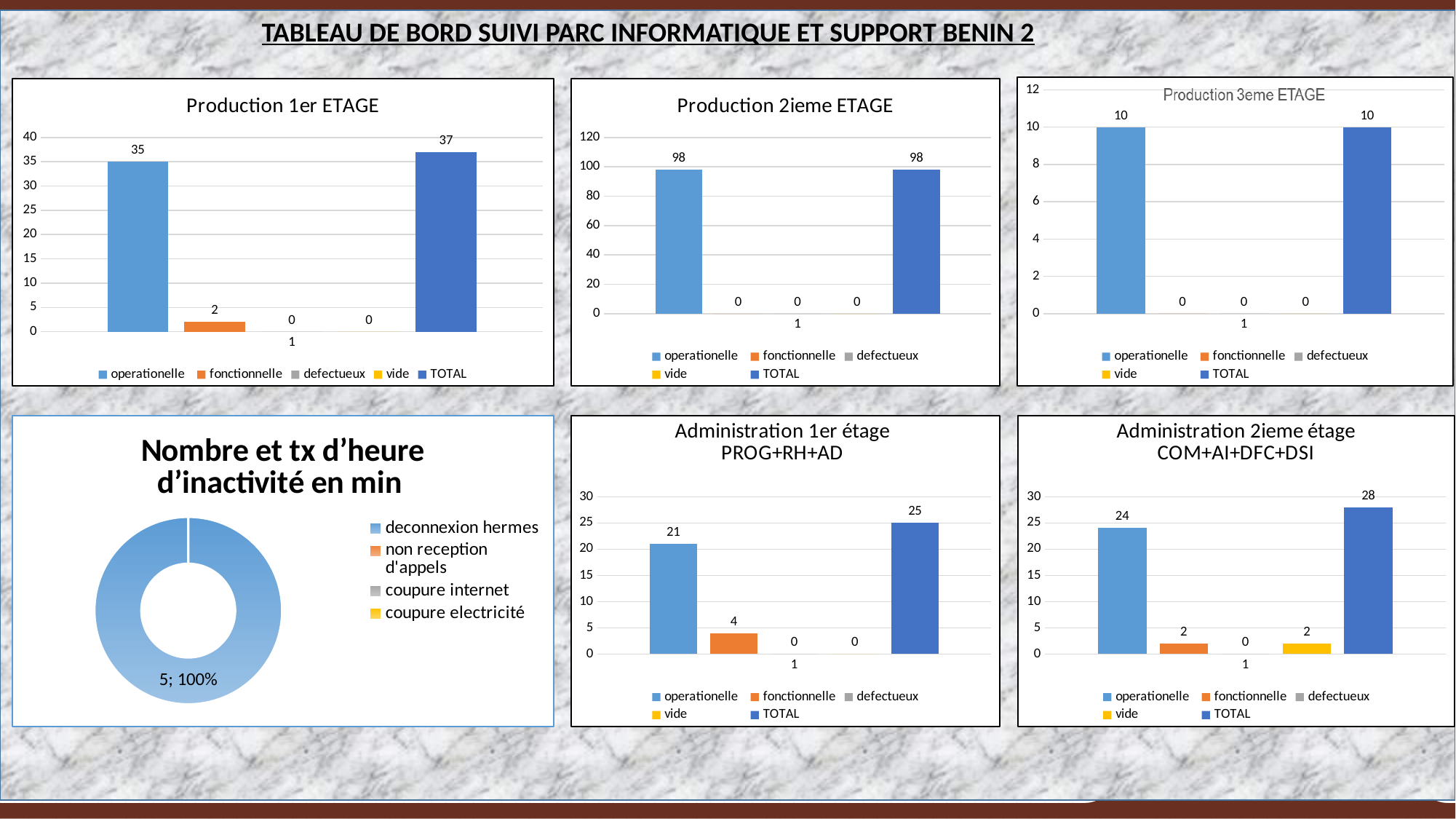
In the 'Nombre et tx d'heure d'inactivité en min' chart, what share does deconnexion hermes have? 100% How many series does the legend of the 'Production 2ieme ETAGE' chart list? 5 In the 'Administration 1er étage PROG+RH+AD' chart, what is the value for fonctionnelle? 4 In the 'Production 2ieme ETAGE' chart, what is the value for operationelle? 98 What type of chart is 'Nombre et tx d'heure d'inactivité en min'? Doughnut chart In the 'Production 3eme ETAGE' chart, what is the value for TOTAL? 10 In the 'Production 1er ETAGE' chart, what is the value for TOTAL? 37 In the 'Production 1er ETAGE' chart, what is the value for operationelle? 35 Which is larger: operationelle in 'Production 1er ETAGE' or operationelle in 'Administration 2ieme étage COM+AI+DFC+DSI'? Production 1er ETAGE In the 'Administration 2ieme étage COM+AI+DFC+DSI' chart, what is the value for vide? 2 In the 'Administration 1er étage PROG+RH+AD' chart, which series has the highest value? TOTAL In the 'Administration 2ieme étage COM+AI+DFC+DSI' chart, what is the difference between TOTAL and operationelle? 4